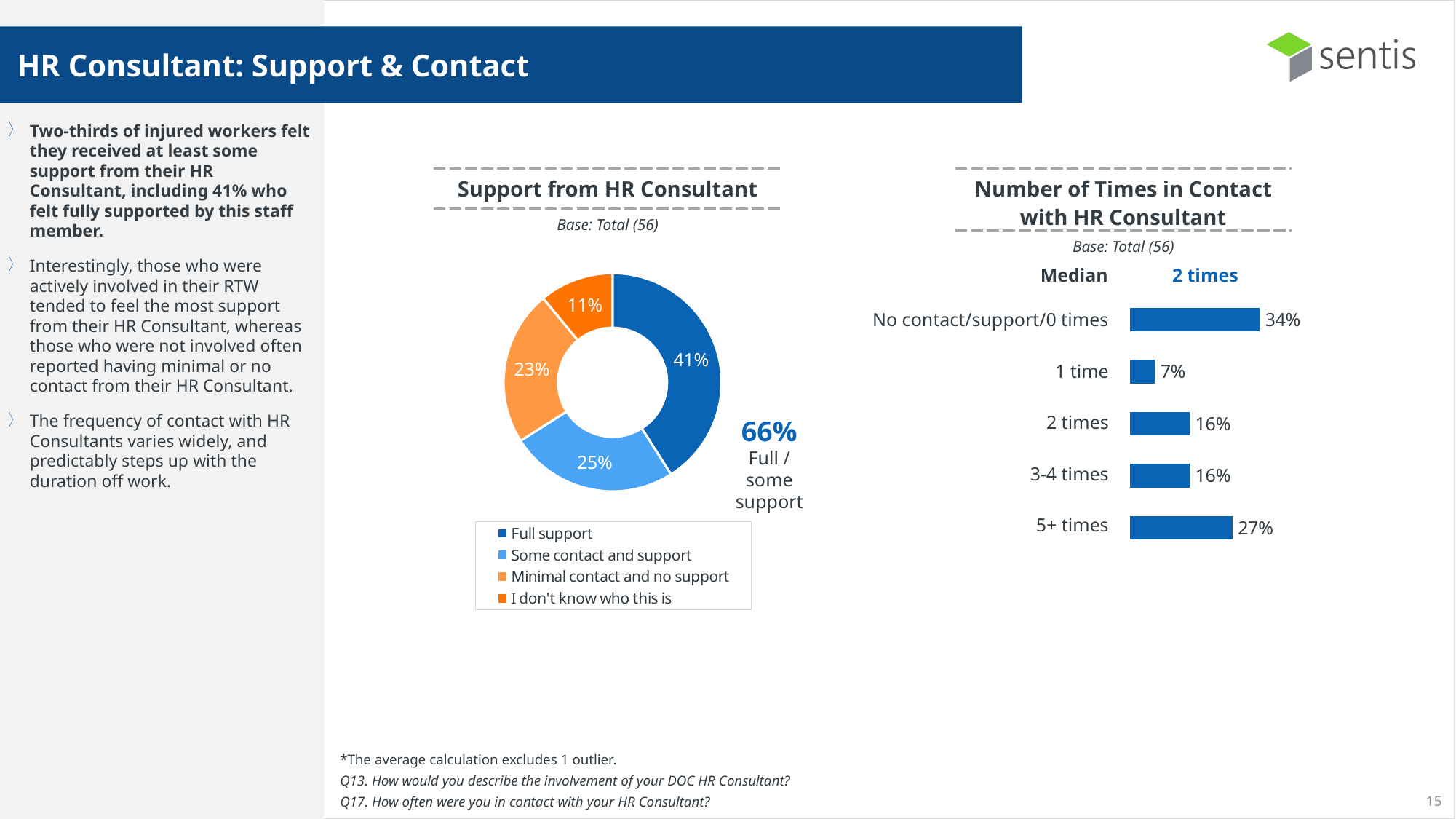
In the 'Support from HR Consultant' chart, what percentage is shown for 'Minimal contact and no support'? 23% In the 'Number of Times in Contact with HR Consultant' chart, what is the difference between 'No contact/support/0 times' and '5+ times'? 7 percentage points In the 'Support from HR Consultant' chart, what percentage of respondents reported full support? 41% In the 'Number of Times in Contact with HR Consultant' chart, which category has the lowest value? 1 time In the 'Number of Times in Contact with HR Consultant' chart, how many categories are plotted? 5 In the 'Support from HR Consultant' chart, which category has the smallest share? I don't know who this is What kind of chart is 'Support from HR Consultant'? Doughnut (pie) chart In the 'Number of Times in Contact with HR Consultant' chart, which category has the highest value? No contact/support/0 times In the 'Number of Times in Contact with HR Consultant' chart, what percentage is shown for '5+ times'? 27% What median value is shown on the 'Number of Times in Contact with HR Consultant' chart? 2 times In the 'Support from HR Consultant' chart, which category has the largest share? Full support In the 'Support from HR Consultant' chart, how many categories does the legend list? 4